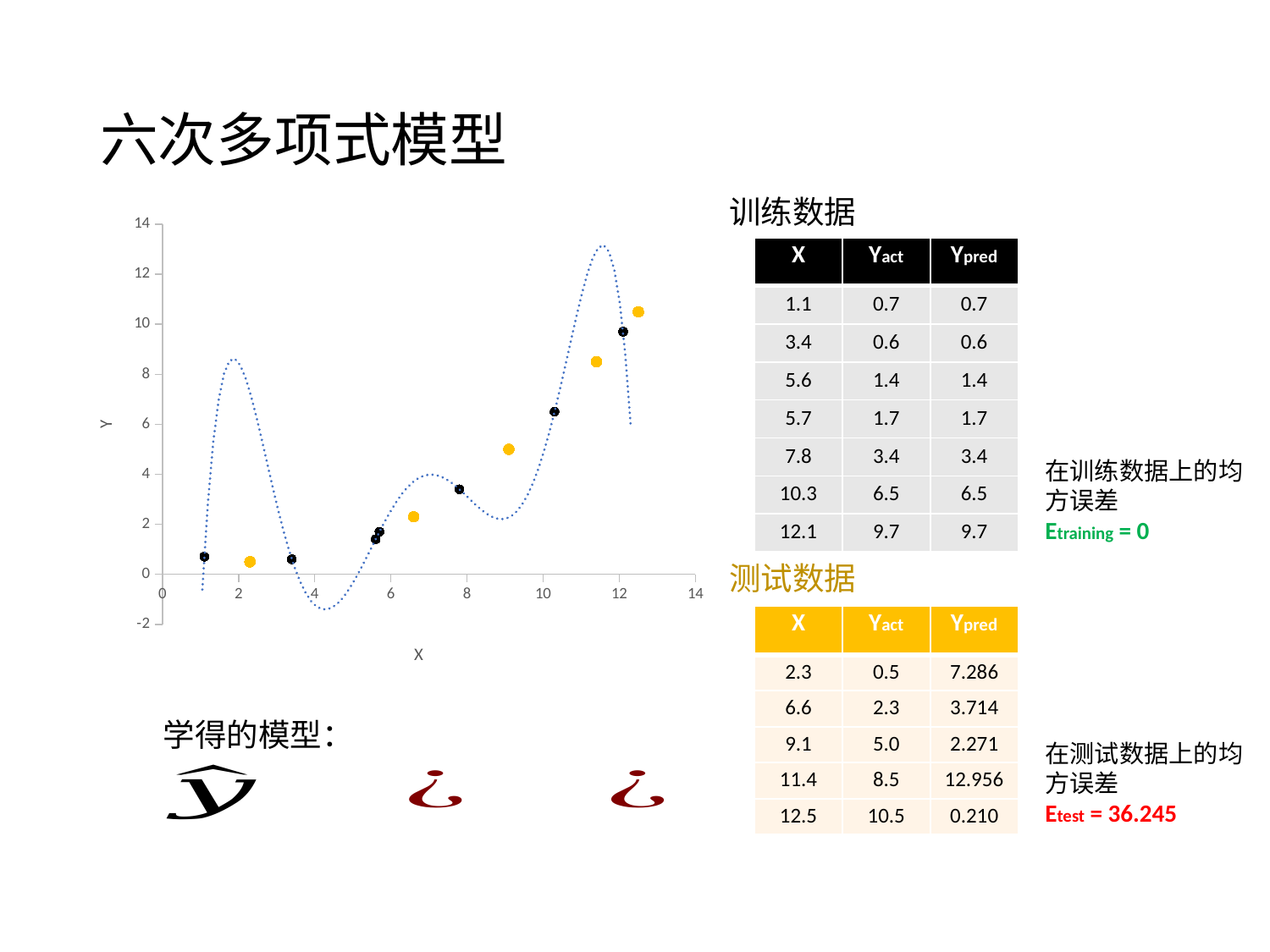
Is the y value of the yellow point near x = 2 greater or less than 2? less Is the dip of the dotted curve near x = 4 greater or less than 0? less Is the y value of the black point near x = 12 greater or less than 8? greater What kind of chart is shown on the slide? scatter chart with a dotted curve How many data points in total are plotted on the chart? 12 How many black (training) points are plotted on the chart? 7 Do the black training points generally rise or fall as x increases from 6 to 12? rise How many yellow (test) points are plotted on the chart? 5 Which plotted point has the highest y value: the yellow point near x = 12.5 or the black point near x = 12? the yellow point near x = 12.5 What is the label of the horizontal axis of the chart? X What is the highest value shown on the y axis of the chart? 14